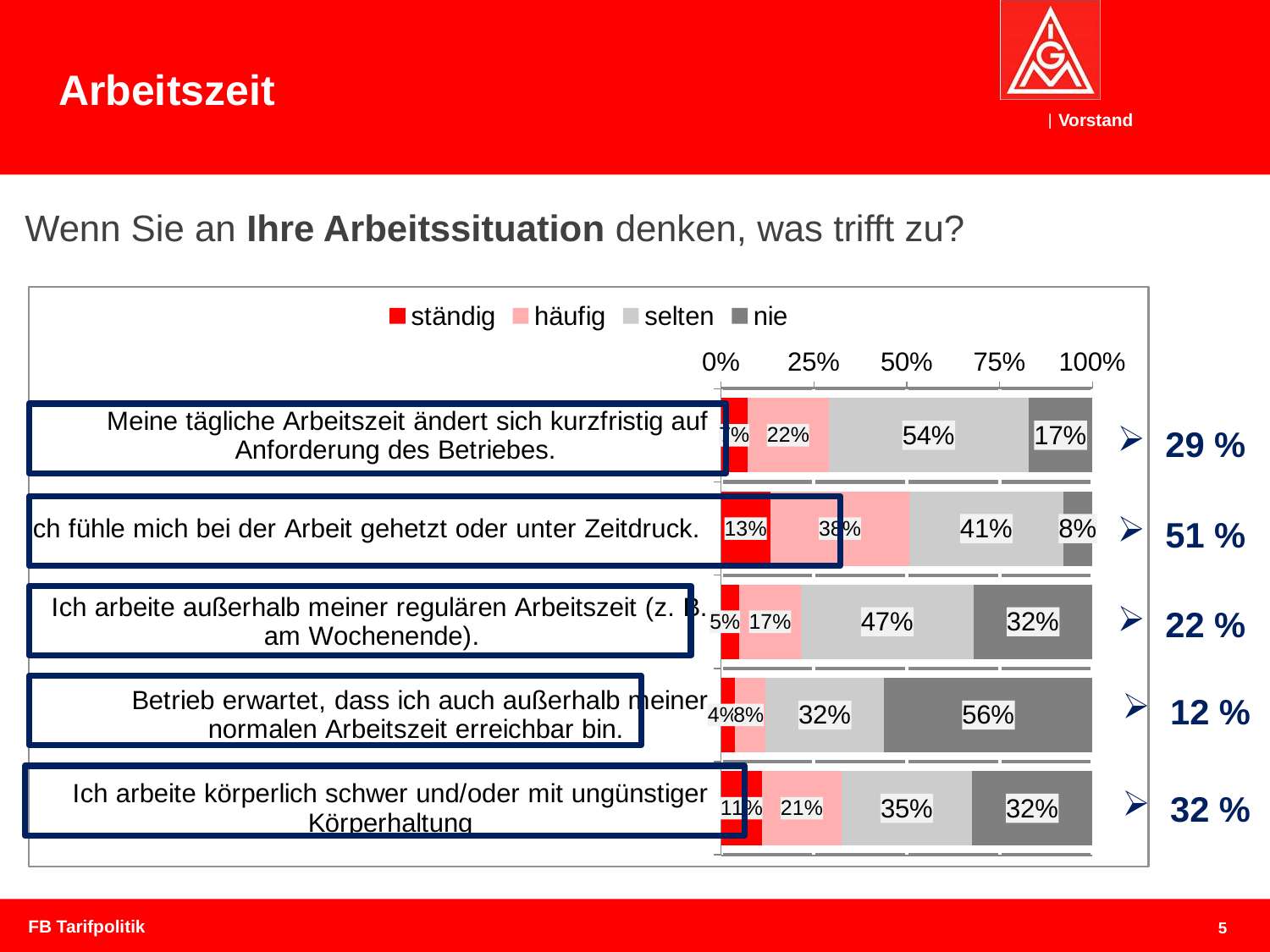
What is the 'nie' value for 'Betrieb erwartet, dass ich auch außerhalb meiner normalen Arbeitszeit erreichbar bin.'? 56% How many statements (categories) are plotted in the chart? 5 What is the 'ständig' value for 'Ich arbeite außerhalb meiner regulären Arbeitszeit (z.B. am Wochenende).'? 5% Which statement has the highest 'nie' value? Betrieb erwartet, dass ich auch außerhalb meiner normalen Arbeitszeit erreichbar bin. Which statement has the lowest 'ständig' value? Betrieb erwartet, dass ich auch außerhalb meiner normalen Arbeitszeit erreichbar bin. What is the 'häufig' value for 'Ich fühle mich bei der Arbeit gehetzt oder unter Zeitdruck.'? 38% What is the 'selten' value for 'Meine tägliche Arbeitszeit ändert sich kurzfristig auf Anforderung des Betriebes.'? 54% What is the difference between the 'selten' value for 'Ich arbeite außerhalb meiner regulären Arbeitszeit' (47%) and the 'selten' value for 'Ich arbeite körperlich schwer und/oder mit ungünstiger Körperhaltung' (35%)? 12% Which is larger: the 'häufig' value for 'Ich fühle mich bei der Arbeit gehetzt oder unter Zeitdruck.' or the 'häufig' value for 'Ich arbeite körperlich schwer und/oder mit ungünstiger Körperhaltung'? Ich fühle mich bei der Arbeit gehetzt oder unter Zeitdruck. Which legend entry is shown in red? ständig What kind of chart is shown on the slide? stacked bar chart How many series does the legend list? 4